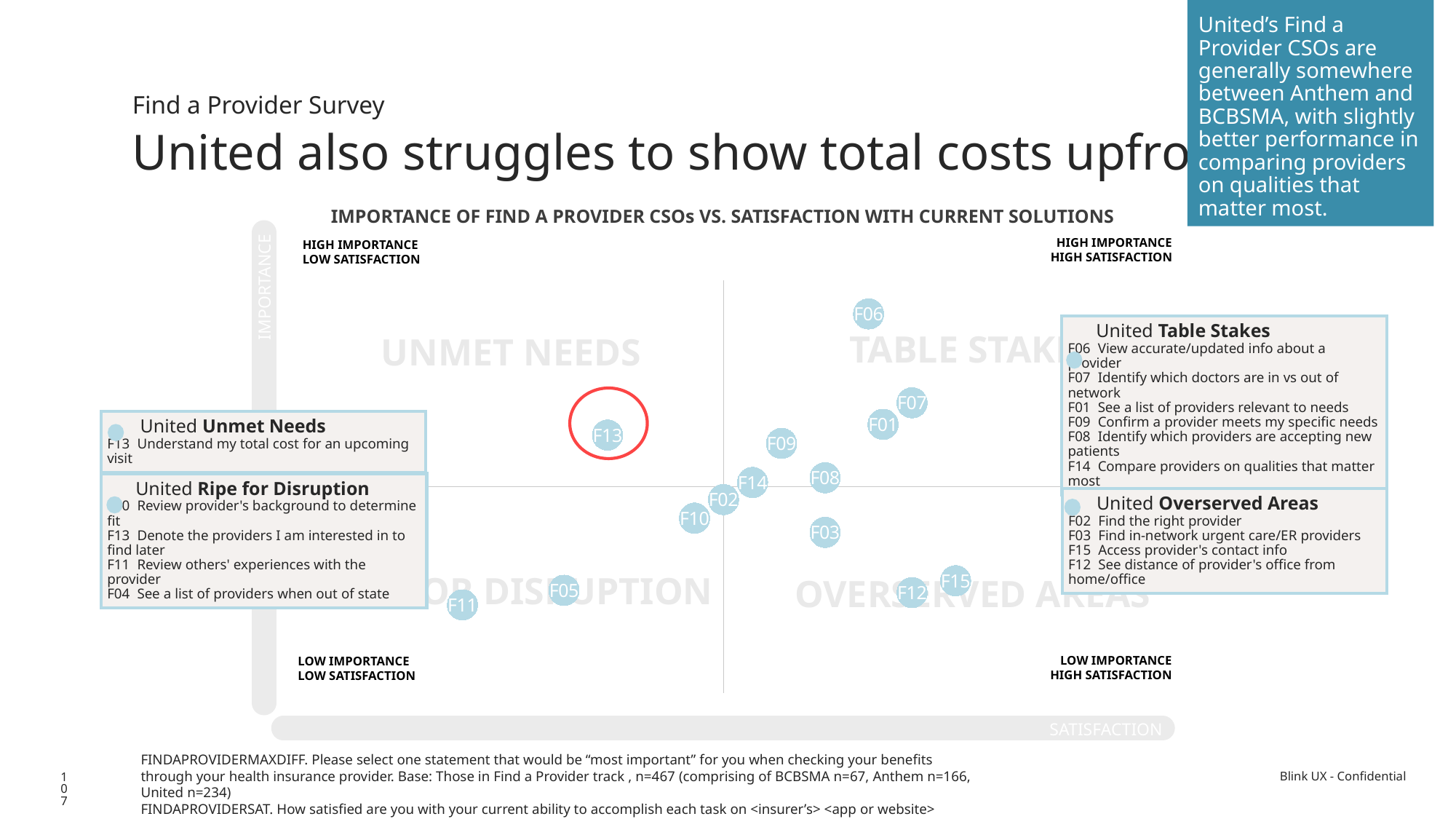
What is the title of the chart? IMPORTANCE OF FIND A PROVIDER CSOs VS. SATISFACTION WITH CURRENT SOLUTIONS What kind of chart is shown on the slide? Scatter chart Which point is plotted furthest to the right on the Satisfaction axis? F15 Which point is further right on the Satisfaction axis, F13 or F07? F07 Which point on the chart is highlighted with a red circle? F13 Which point is plotted highest on the Importance axis? F06 In which quadrant of the chart does point F06 fall? Table Stakes Which point is higher on the Importance axis, F06 or F11? F06 Which point is plotted lowest on the Importance axis? F11 Which point is plotted furthest to the left on the Satisfaction axis? F11 Which point is higher on the Importance axis, F13 or F05? F13 In which quadrant of the chart does point F13 fall? Unmet Needs